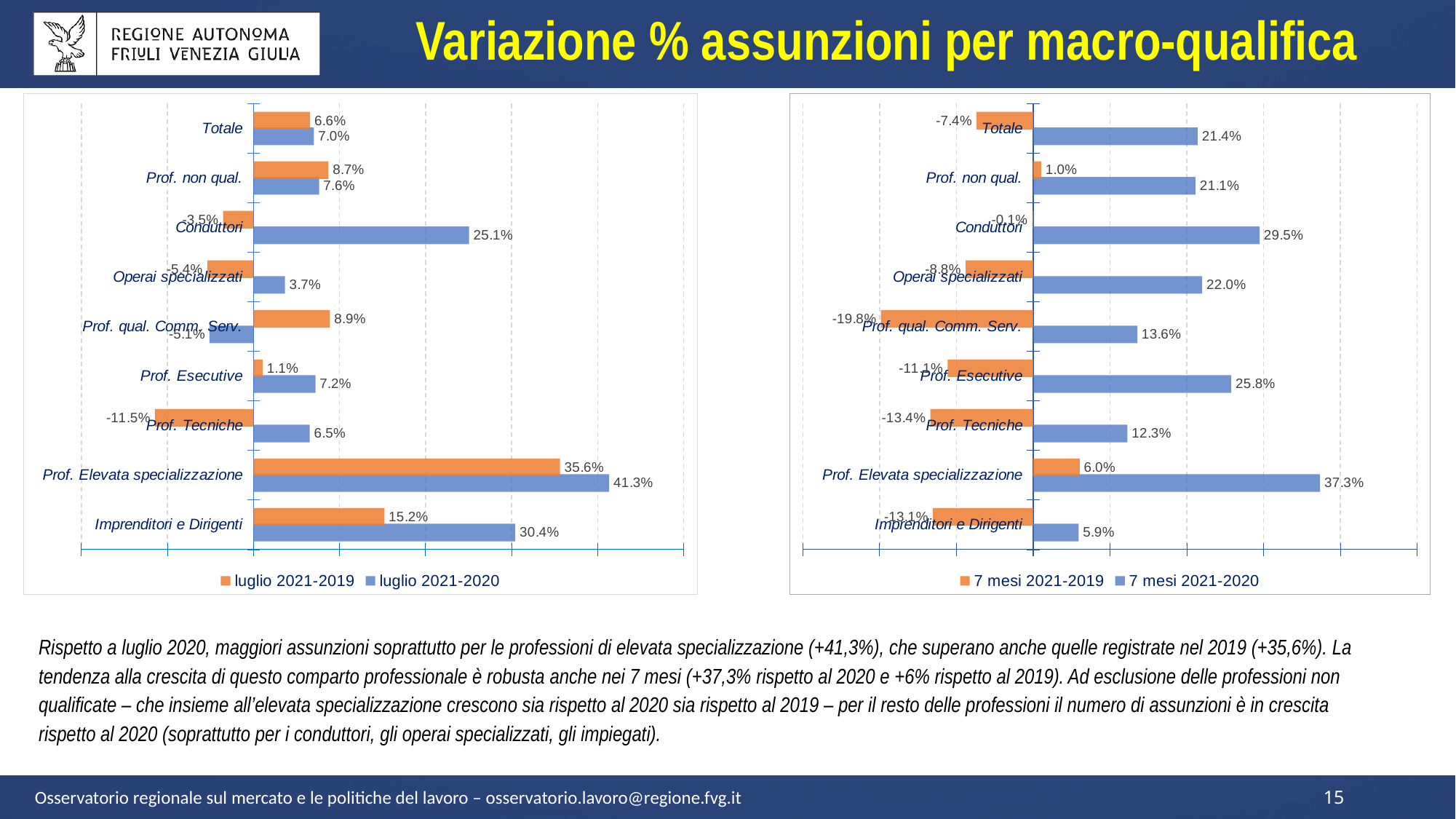
In the left chart, what is the value for Prof. Elevata specializzazione in the luglio 2021-2020 series? 41.3% In the left chart, what is the value for Conduttori in the luglio 2021-2019 series? -3.5% In the left chart, which category has the highest value in the luglio 2021-2019 series? Prof. Elevata specializzazione How many series does the legend of the right chart list? 2 In the right chart, what is the value for Totale in the 7 mesi 2021-2020 series? 21.4% In the right chart, which category has the lowest value in the 7 mesi 2021-2019 series? Prof. qual. Comm. Serv. In the right chart, which is larger for Conduttori: the 7 mesi 2021-2019 value or the 7 mesi 2021-2020 value? 7 mesi 2021-2020 In the right chart, what is the value for Prof. qual. Comm. Serv. in the 7 mesi 2021-2019 series? -19.8% In the left chart, what is the difference between the luglio 2021-2020 and luglio 2021-2019 values for Imprenditori e Dirigenti? 15.2% What type of chart is the left chart? Bar chart How many categories are shown in the left chart? 9 In the right chart, which category has the highest value in the 7 mesi 2021-2020 series? Prof. Elevata specializzazione